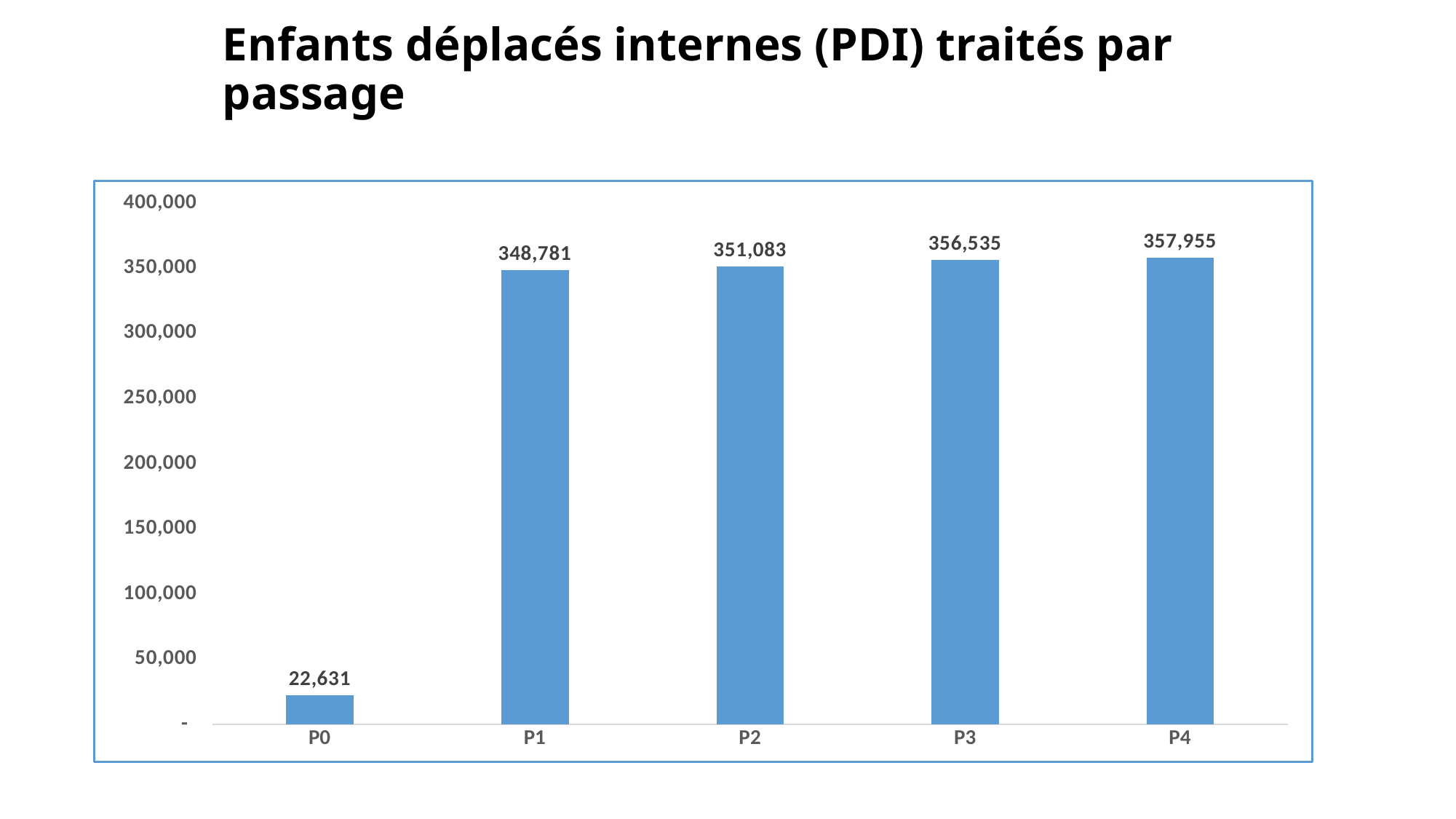
Which passage has the lowest value? P0 Do the values rise or fall from P0 to P4? rise What is the difference between the values for P1 and P0? 326,150 What is the value for P2? 351,083 Which is larger, the value for P3 or the value for P2? P3 Is the value for P0 greater or less than 50,000? less What is the value for P4? 357,955 What is the value for P0? 22,631 How many passages are shown on the x axis? 5 What is the difference between the values for P4 and P1? 9,174 Which passage has the highest value? P4 What kind of chart is shown on the slide? bar chart